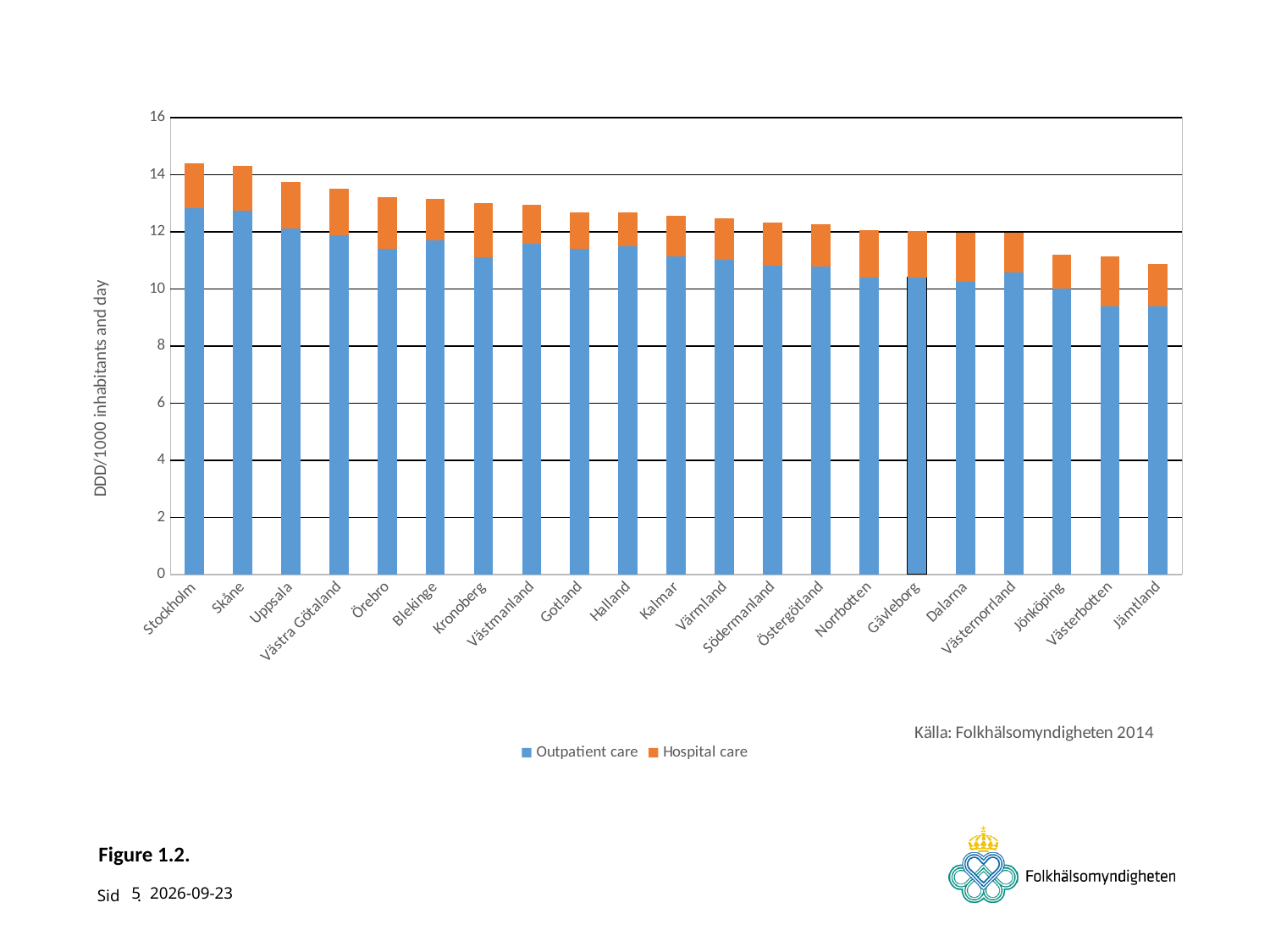
How many counties (categories) are plotted on the x axis? 21 Is the total value for Jämtland greater or less than 12? less Do the total bar heights rise or fall moving from left to right along the x axis? Fall Which county has the lowest total bar? Jämtland How many series does the legend list? 2 What are the two series named in the legend? Outpatient care and Hospital care What kind of chart is shown on the slide? Stacked bar chart Is the total value for Stockholm greater or less than 14? greater What is the label on the y axis? DDD/1000 inhabitants and day Is the Outpatient care value for Stockholm greater or less than 12? greater Which has the larger total bar, Stockholm or Jämtland? Stockholm